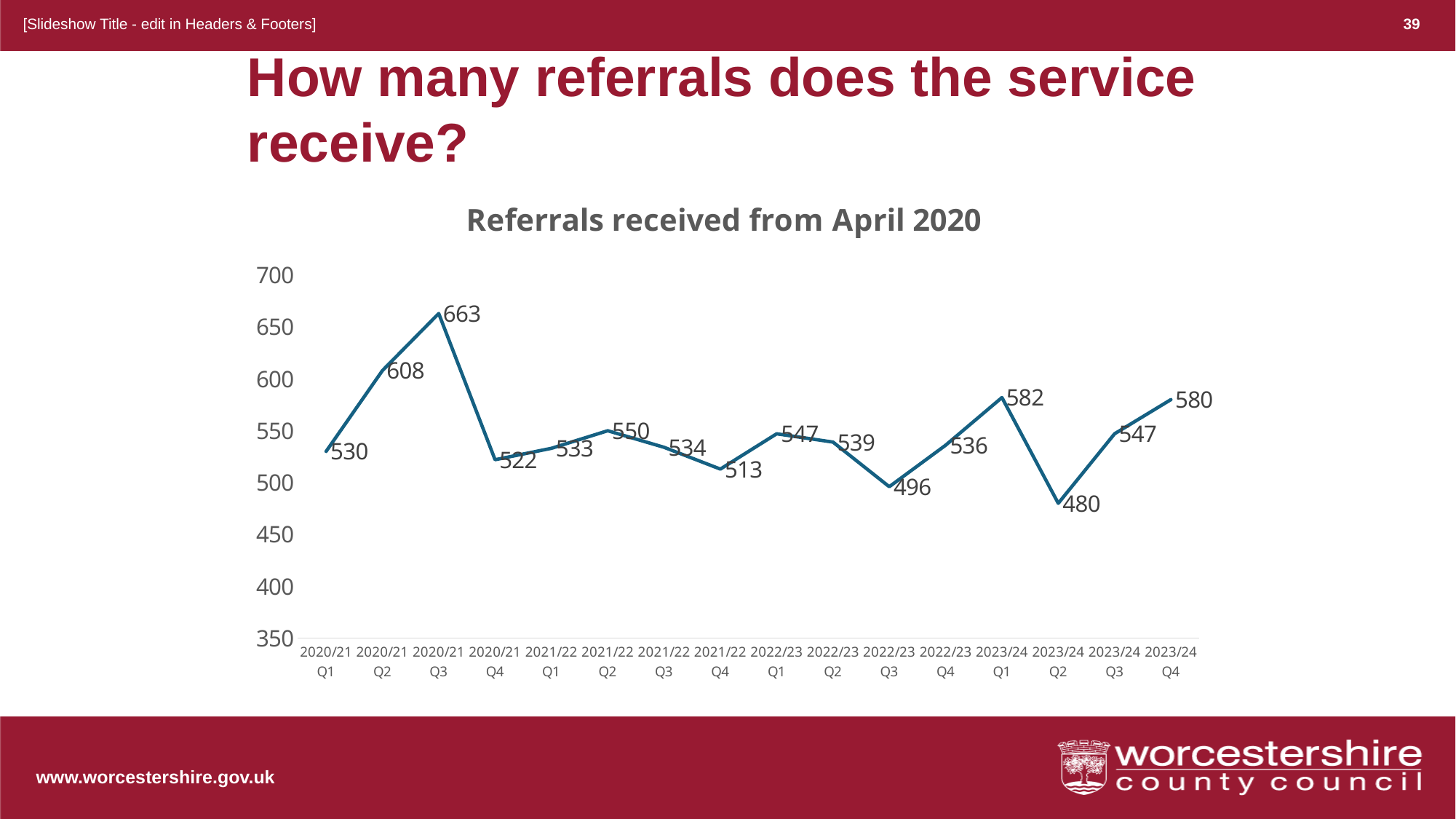
What is the value for 2023/24 Q2? 480 What is the difference between the values for 2020/21 Q3 and 2020/21 Q4? 141 Which quarter has the lowest number of referrals? 2023/24 Q2 Which is larger, the value for 2022/23 Q1 or the value for 2022/23 Q3? 2022/23 Q1 What kind of chart is shown on the slide? line chart What is the value for 2021/22 Q4? 513 Is the value for 2020/21 Q2 greater or less than 600? greater What is the title of the chart? Referrals received from April 2020 What is the difference between the values for 2023/24 Q1 and 2023/24 Q2? 102 How many quarters are plotted on the chart? 16 Which quarter has the highest number of referrals? 2020/21 Q3 What is the value for 2020/21 Q3? 663